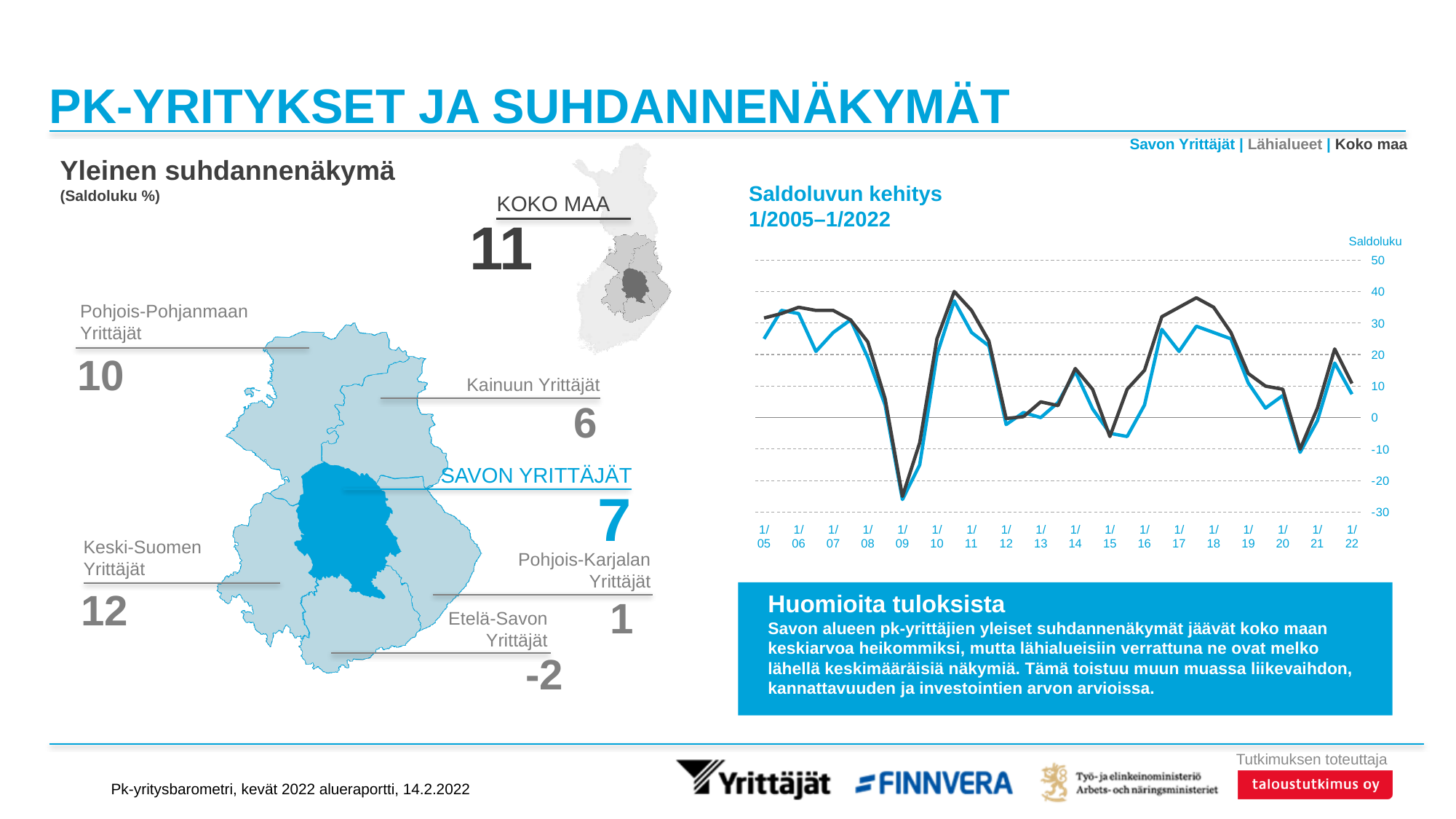
In the 'Saldoluvun kehitys 1/2005–1/2022' chart, which line has the higher value at 1/18, the dark line or the blue line? the dark line In the 'Saldoluvun kehitys 1/2005–1/2022' chart, do the lines rise or fall between 1/08 and 1/09? fall On the map, what is the value shown for KOKO MAA? 11 What is the title of the line chart on the right of the slide? Saldoluvun kehitys 1/2005–1/2022 In the 'Saldoluvun kehitys 1/2005–1/2022' chart, is the value of the dark line at 1/18 greater or less than 30? greater In the 'Saldoluvun kehitys 1/2005–1/2022' chart, is the value of the blue line at 1/09 greater or less than -20? less On the map, what is the value shown for Etelä-Savon Yrittäjät? -2 How many lines are plotted in the 'Saldoluvun kehitys 1/2005–1/2022' chart? 2 How many time points are shown on the x axis of the 'Saldoluvun kehitys 1/2005–1/2022' chart? 18 In the 'Saldoluvun kehitys 1/2005–1/2022' chart, at which time point do both lines reach their lowest value? 1/09 What kind of chart is 'Saldoluvun kehitys 1/2005–1/2022'? line chart